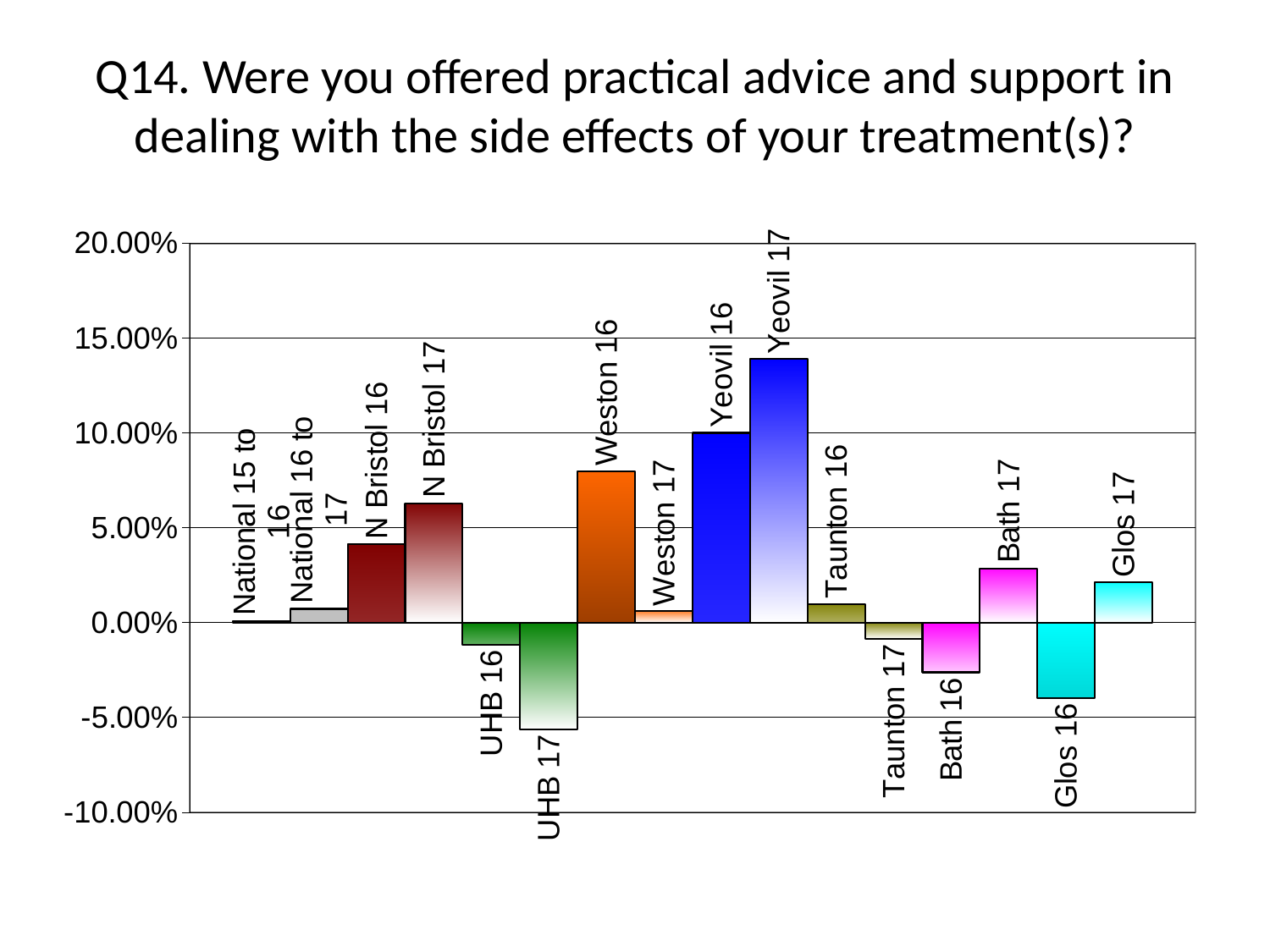
Is the value for UHB 17 greater or less than -5.00%? less Which category has the highest value in the chart? Yeovil 17 Is the value for N Bristol 17 greater or less than 5.00%? greater What kind of chart is shown on the slide? bar chart Which is larger, the value for Weston 16 or Weston 17? Weston 16 Is the value for Weston 16 greater or less than 5.00%? greater What is the title of the chart on the slide? Q14. Were you offered practical advice and support in dealing with the side effects of your treatment(s)? Which category has the lowest value in the chart? UHB 17 Which is larger, the value for N Bristol 16 or N Bristol 17? N Bristol 17 How many bars (categories) are plotted in the chart? 16